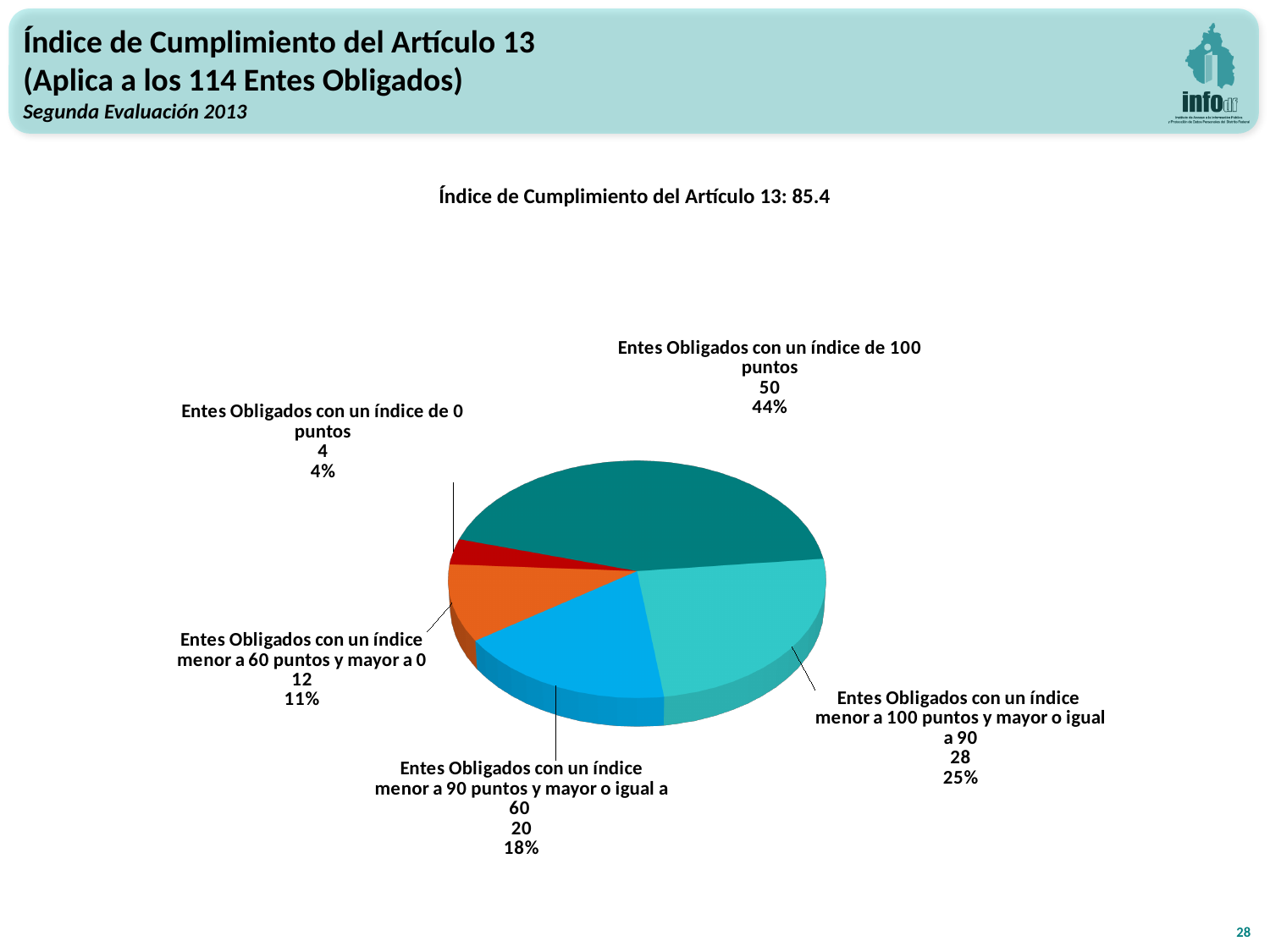
What is the Índice de Cumplimiento del Artículo 13 stated above the chart? 85.4 Which is larger: the number of Entes Obligados with an índice menor a 60 puntos y mayor a 0, or those with an índice menor a 90 puntos y mayor o igual a 60? Entes Obligados con un índice menor a 90 puntos y mayor o igual a 60 How many Entes Obligados have an índice de 100 puntos? 50 What share of the pie is Entes Obligados con un índice menor a 90 puntos y mayor o igual a 60? 18% How many Entes Obligados have an índice de 0 puntos? 4 Which category has the smallest slice of the pie? Entes Obligados con un índice de 0 puntos Which category has the largest slice of the pie? Entes Obligados con un índice de 100 puntos What percentage of the pie corresponds to Entes Obligados con un índice de 100 puntos? 44% How many slices does the pie chart have? 5 What is the difference between the number of Entes Obligados with an índice de 100 puntos and those with an índice menor a 100 puntos y mayor o igual a 90? 22 What kind of chart is shown on the slide? Pie chart How many Entes Obligados have an índice menor a 100 puntos y mayor o igual a 90? 28